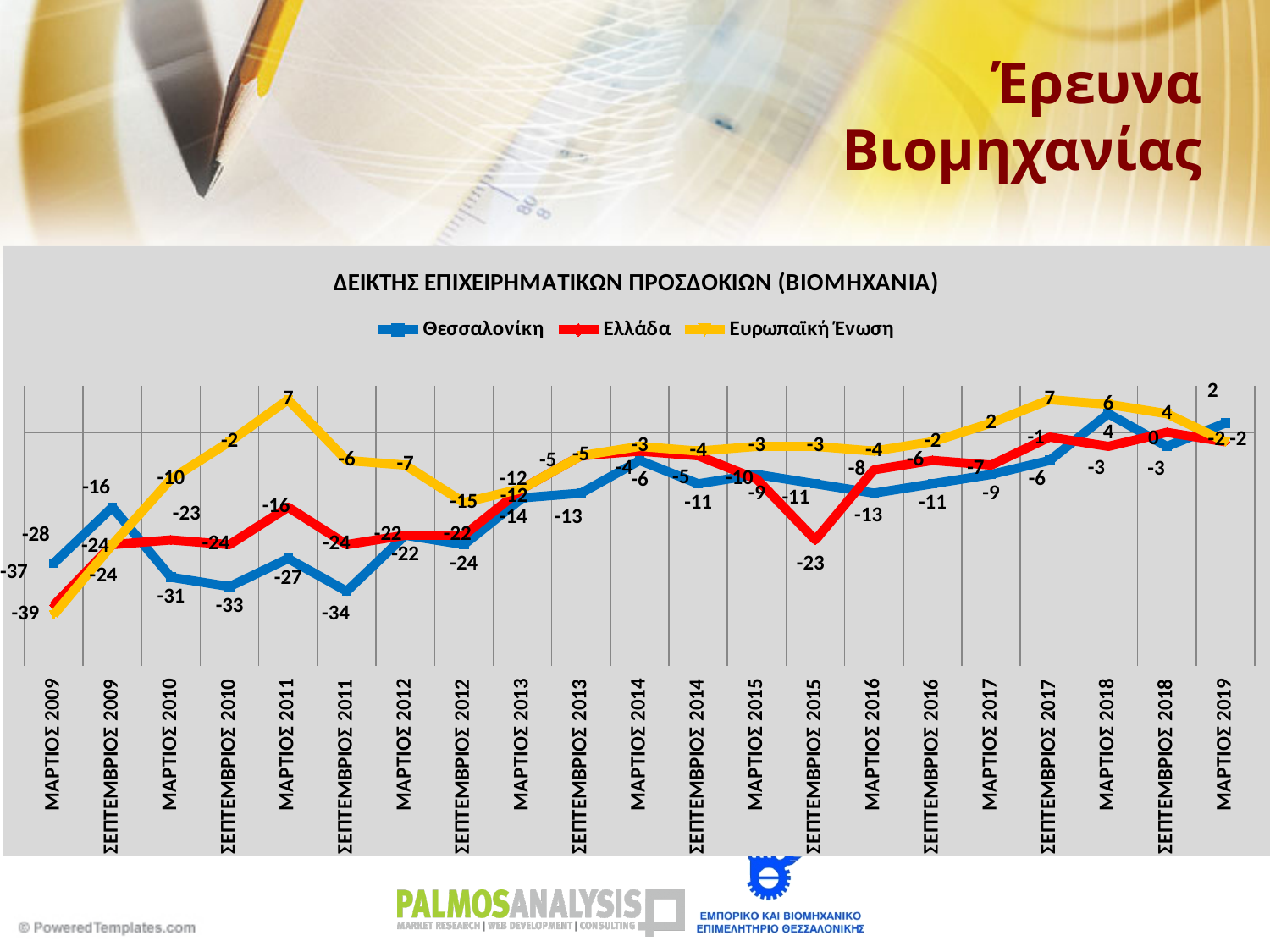
In ΣΕΠΤΕΜΒΡΙΟΣ 2015, which is higher: Θεσσαλονίκη or Ελλάδα? Θεσσαλονίκη How many time points are shown on the x axis? 21 Does the Θεσσαλονίκη series overall rise or fall from ΜΑΡΤΙΟΣ 2009 to ΜΑΡΤΙΟΣ 2019? Rise What is the value for Θεσσαλονίκη in ΜΑΡΤΙΟΣ 2009? -28 In which period does Ευρωπαϊκή Ένωση have its lowest value? ΜΑΡΤΙΟΣ 2009 In which period does Θεσσαλονίκη reach its lowest value? ΣΕΠΤΕΜΒΡΙΟΣ 2011 What colour is the Ελλάδα line in the legend? Red What is the difference between the Θεσσαλονίκη values in ΣΕΠΤΕΜΒΡΙΟΣ 2009 and ΜΑΡΤΙΟΣ 2009? 12 What is the value for Ελλάδα in ΣΕΠΤΕΜΒΡΙΟΣ 2015? -23 What is the value for Ευρωπαϊκή Ένωση in ΜΑΡΤΙΟΣ 2011? 7 How many series does the legend list? 3 What kind of chart is shown on the slide? Line chart